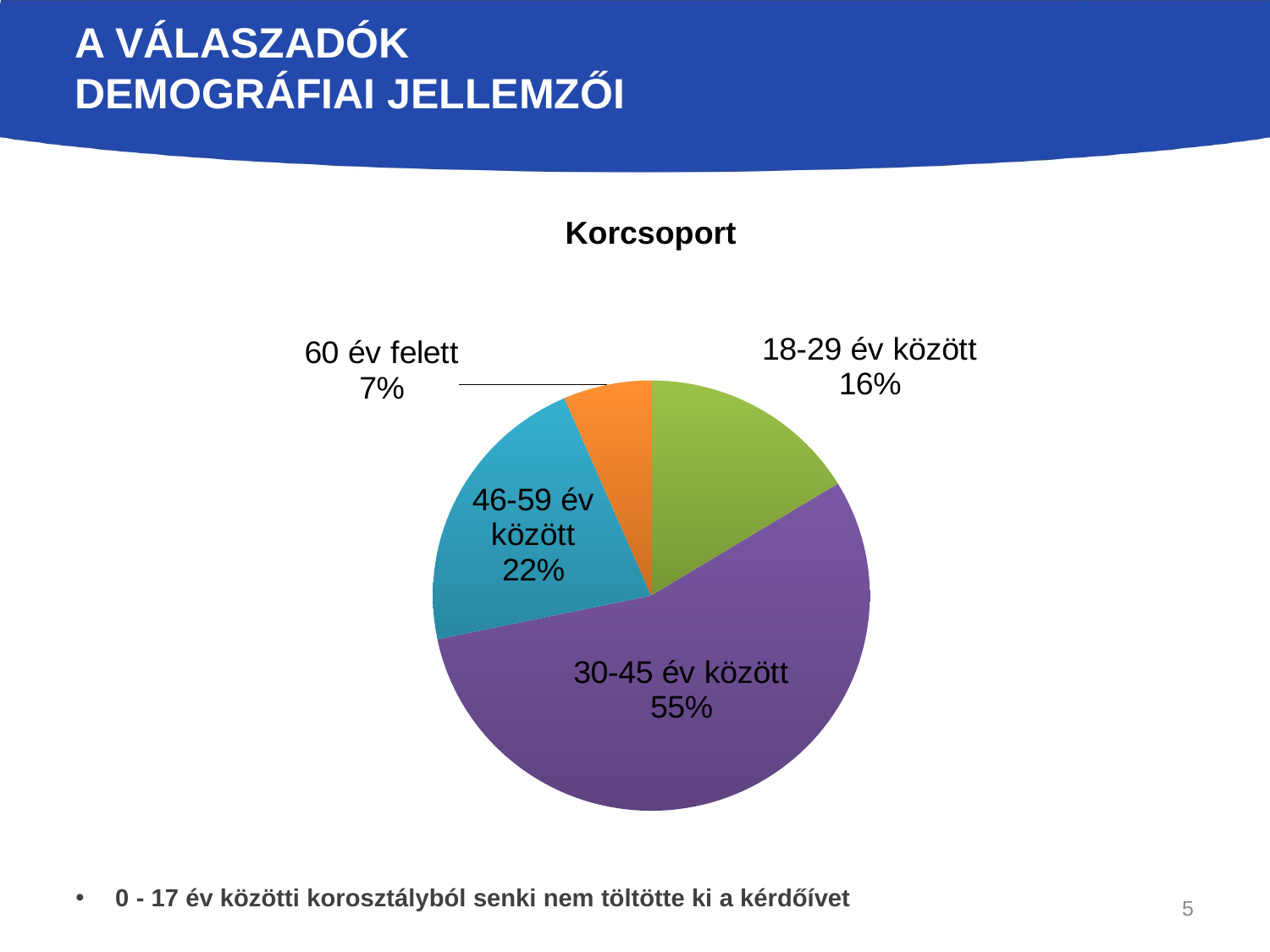
What share of respondents are in the 46-59 év között age group? 22% What share of respondents are in the 18-29 év között age group? 16% Which is larger, the share for 18-29 év között or for 46-59 év között? 46-59 év között How many age groups are shown in the pie chart? 4 What share of respondents are 60 év felett? 7% What colour is the slice for 30-45 év között? purple What is the title of the chart? Korcsoport Which age group has the smallest share of the pie? 60 év felett Which age group has the largest share of the pie? 30-45 év között What is the difference in percentage points between the 30-45 év között and 46-59 év között groups? 33 What kind of chart is shown on the slide? pie chart What share of respondents are in the 30-45 év között age group? 55%